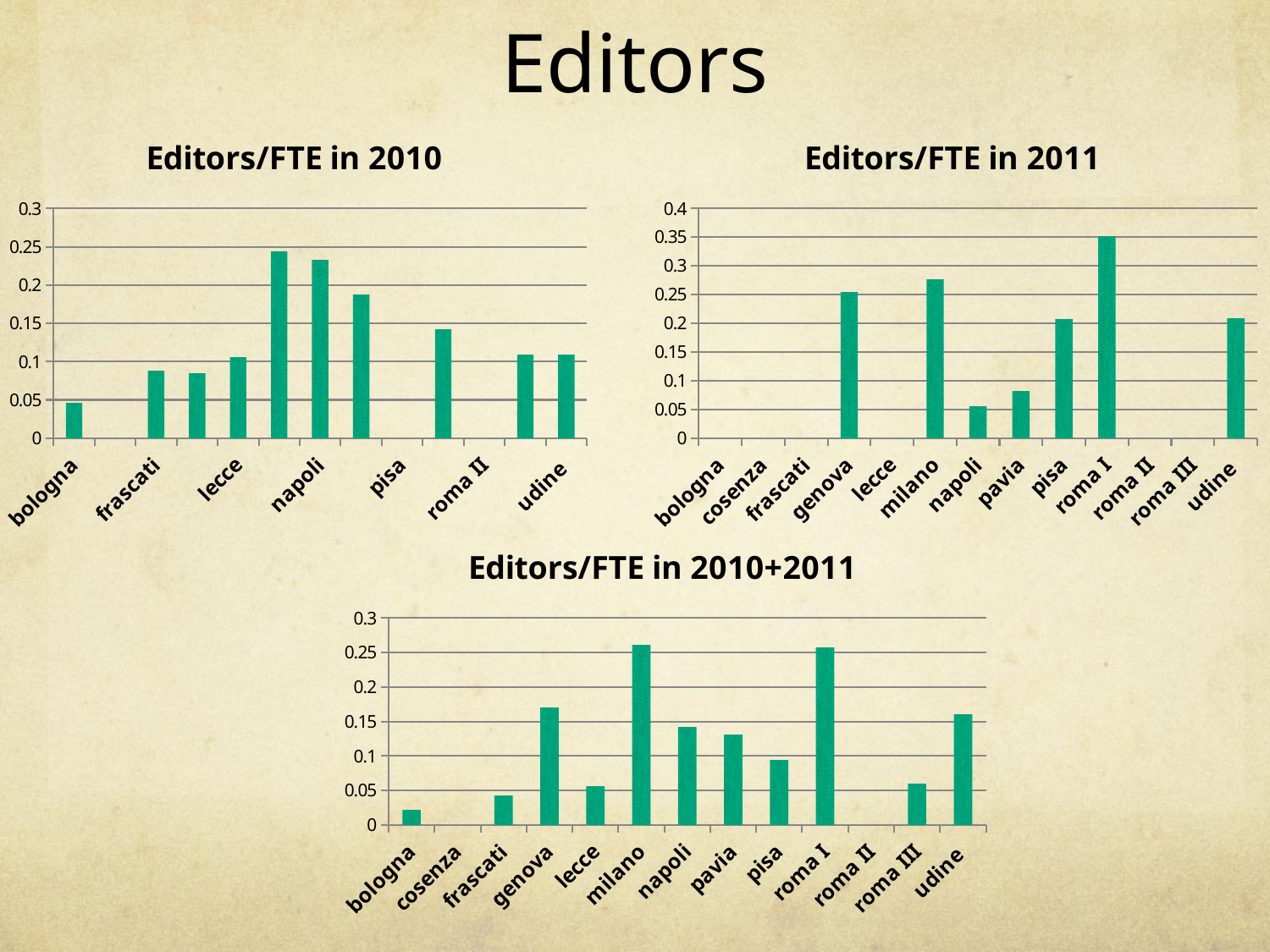
What is the highest value shown on the y axis of the "Editors/FTE in 2011" chart? 0.4 What kind of chart is "Editors/FTE in 2011"? bar chart How many charts are shown on the slide? 3 In the "Editors/FTE in 2010" chart, is the value for napoli greater or less than 0.2? greater In the "Editors/FTE in 2011" chart, which is larger, the value for milano or the value for napoli? milano In the "Editors/FTE in 2010+2011" chart, which is larger, the value for genova or the value for lecce? genova In the "Editors/FTE in 2011" chart, which category has the highest value? roma I In the "Editors/FTE in 2010" chart, is the value for bologna greater or less than 0.1? less In the "Editors/FTE in 2011" chart, how many categories are labelled on the x axis? 13 In the "Editors/FTE in 2011" chart, is the value for milano greater or less than 0.25? greater